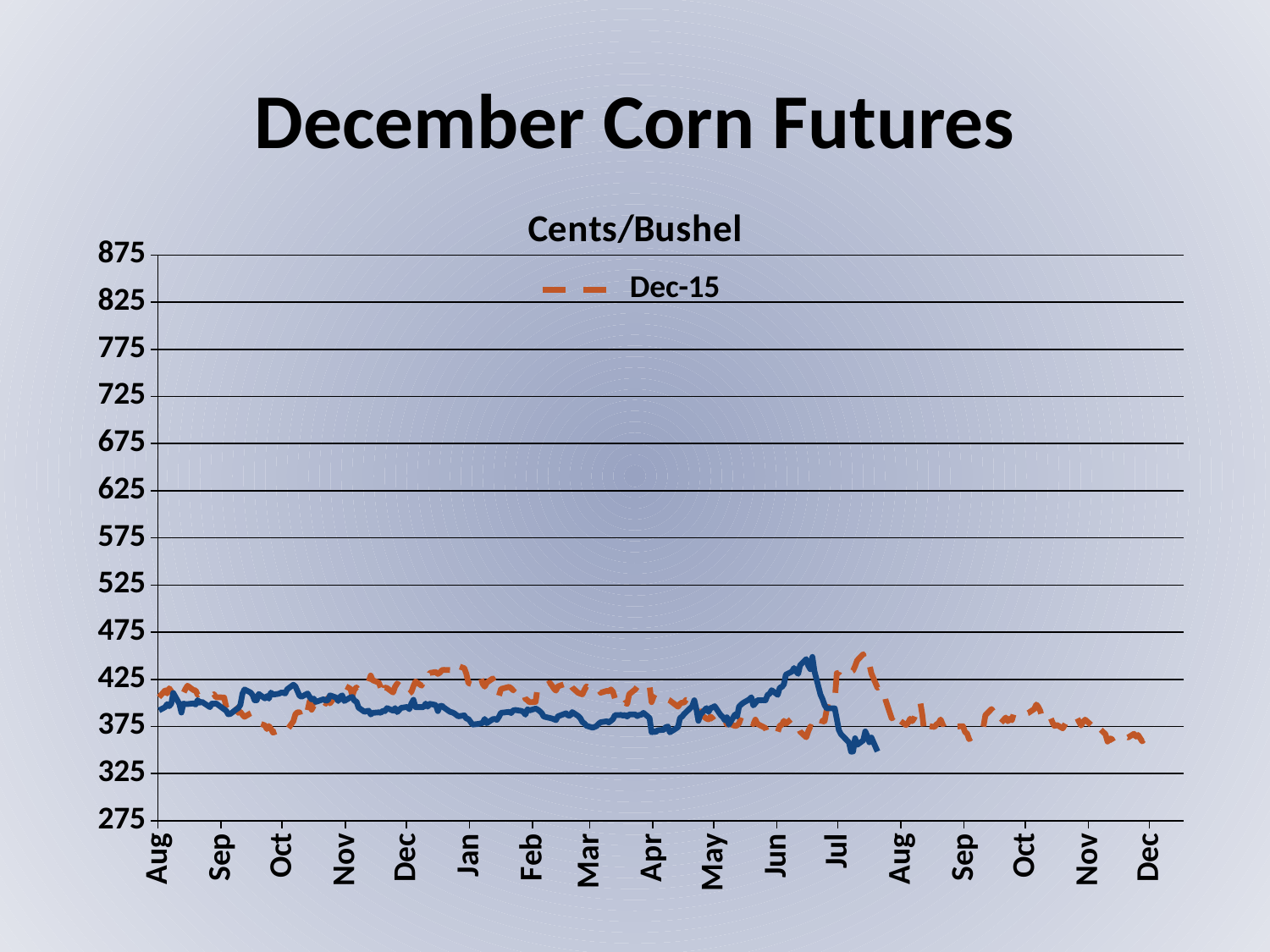
Is the Dec-15 value at the final Dec label greater or less than 375? less How many series does the legend list? 1 What is the lowest value shown on the y axis? 275 What kind of chart is shown on the slide? line chart What unit label appears above the chart? Cents/Bushel What is the highest value shown on the y axis? 875 How many month labels are shown along the x axis? 17 Does the Dec-15 line end higher or lower than where it starts at the first Aug label? lower What is the title of the slide's chart? Cents/Bushel Is the last value of the solid blue line, just after Jul, greater or less than 375? less Is the peak of the solid blue line, reached around late Jun, greater or less than 425? greater